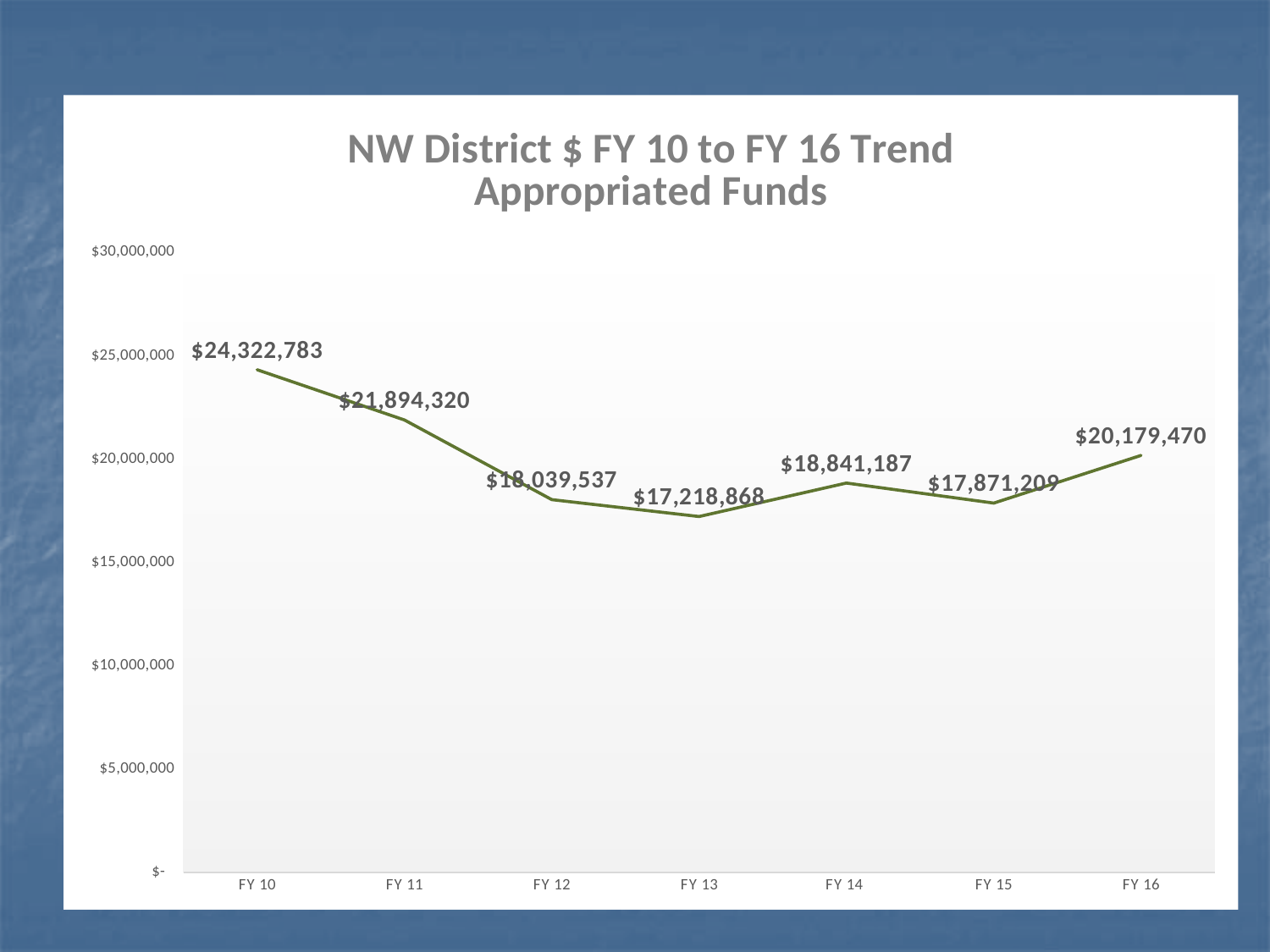
Is the value for FY 12 greater or less than $20,000,000? less Which is larger, the value for FY 14 or the value for FY 15? FY 14 How many fiscal years are plotted on the chart? 7 What is the difference between the FY 16 and FY 15 values? $2,308,261 What kind of chart is shown on the slide? line chart What is the value for FY 13? $17,218,868 What is the value for FY 10? $24,322,783 What is the difference between the FY 10 and FY 11 values? $2,428,463 Which fiscal year has the highest value? FY 10 Which fiscal year has the lowest value? FY 13 Do the values rise or fall from FY 10 to FY 13? fall What is the value for FY 16? $20,179,470